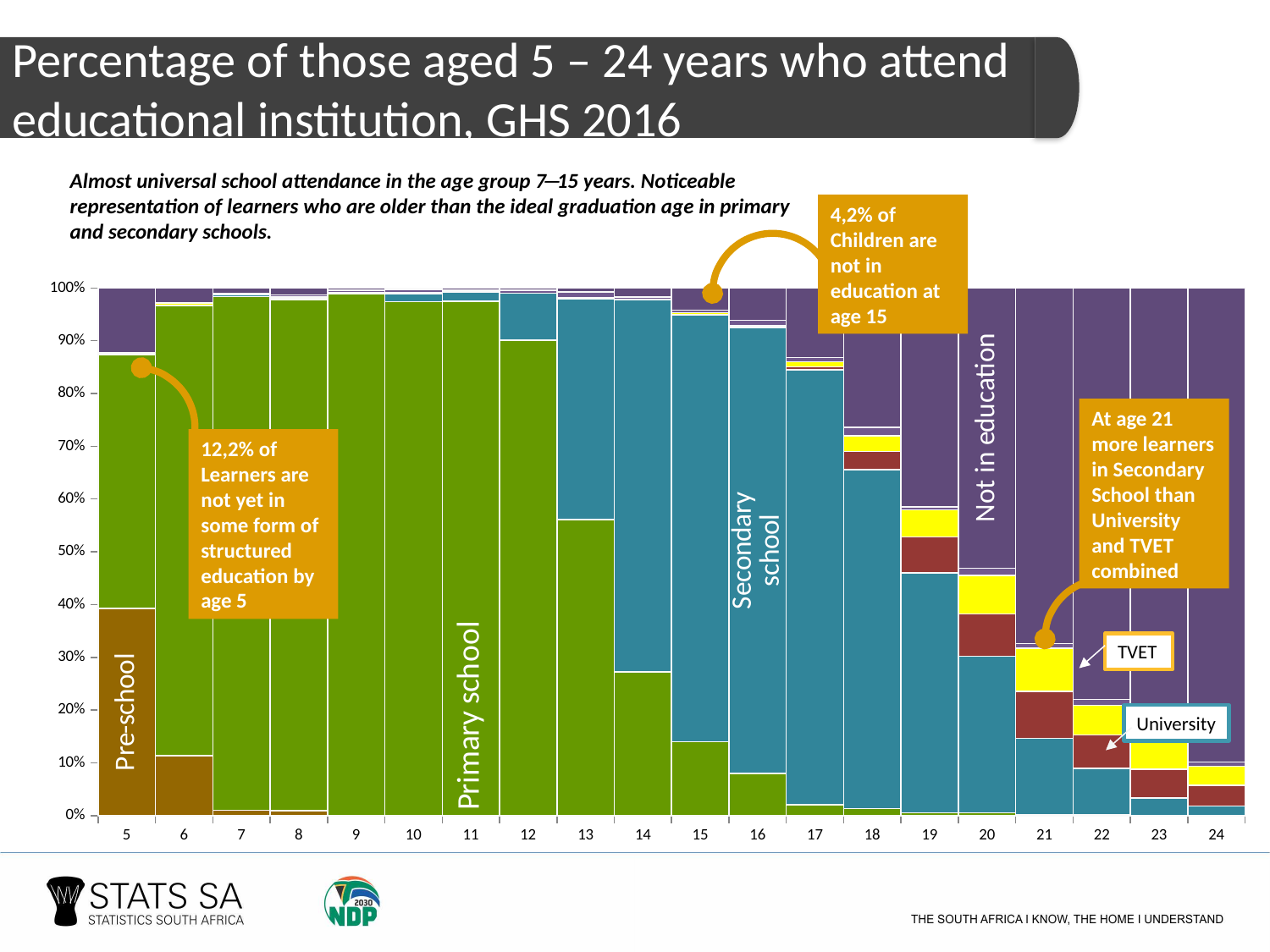
Is the primary school share at age 12 greater or less than 80%? greater Does the 'Not in education' share rise or fall as age increases from 15 to 24? Rise Does the primary school share rise or fall as age increases from 9 to 15? Fall Is the pre-school share at age 5 greater or less than 30%? greater Which colour represents 'Not in education' in the chart? Purple Is the secondary school share at age 18 greater or less than 50%? greater What kind of chart is shown on the slide? Stacked bar chart At age 21, which is larger: the secondary school share or the university share? Secondary school Which age has the largest 'Not in education' share? 24 According to the callout, what percentage of learners are not yet in some form of structured education by age 5? 12,2% How many age categories are shown along the x axis? 20 According to the callout, what percentage of children are not in education at age 15? 4,2%